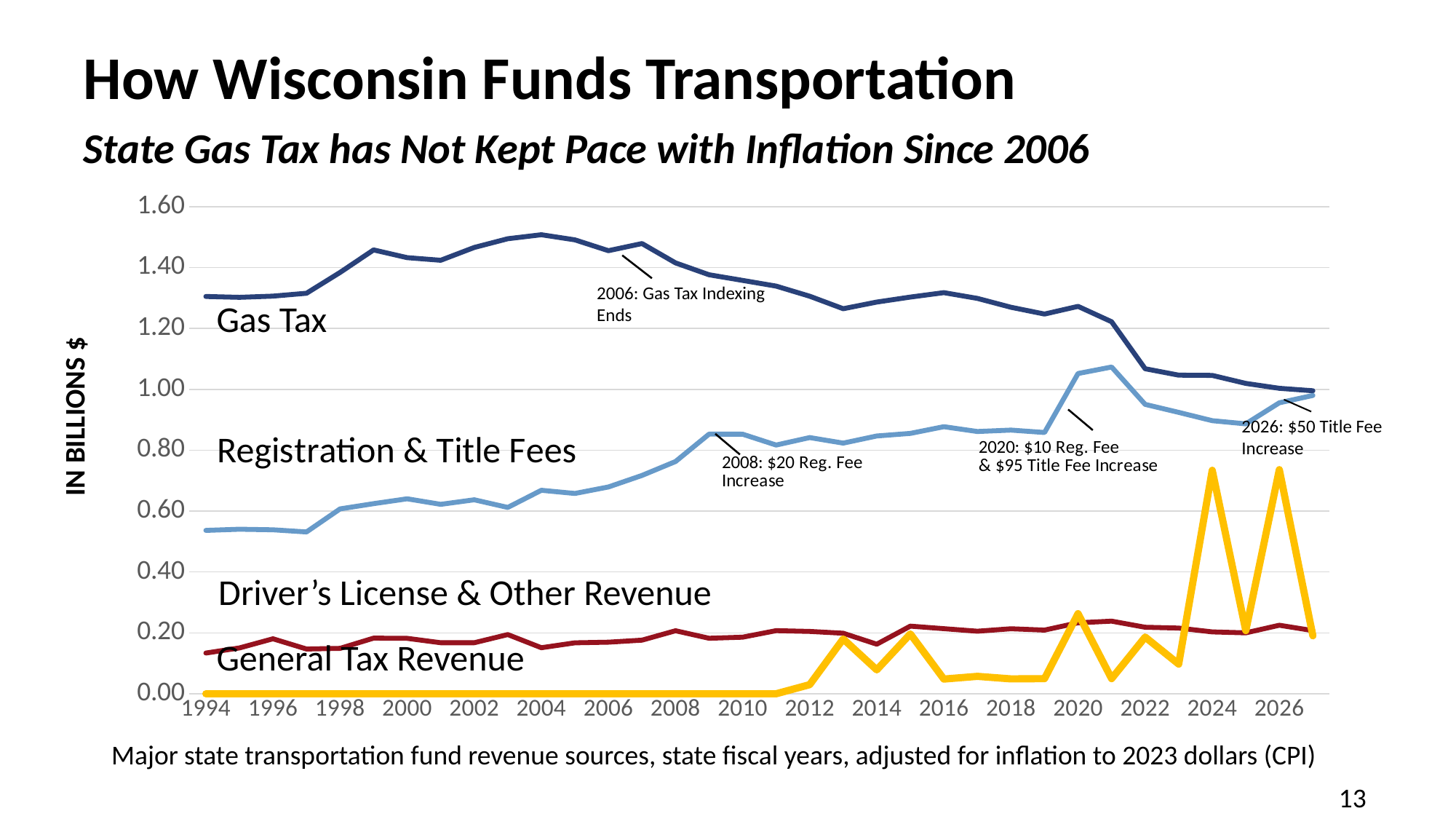
Is the Driver's License & Other Revenue value in 2024 greater or less than 0.60? less What event does the chart annotation mark in 2006? Gas Tax Indexing Ends Does the Gas Tax line rise or fall from 2007 to 2027? Fall Is the Gas Tax value in 2004 greater or less than 1.40? greater Is the Registration & Title Fees value in 2021 greater or less than 1.00? greater How many revenue source series are plotted on the chart? 4 Which is larger in 2010, Gas Tax or Registration & Title Fees? Gas Tax Which revenue source has the highest value in 2004? Gas Tax What kind of chart is shown on the slide? Line chart What is the label on the y axis of the chart? IN BILLIONS $